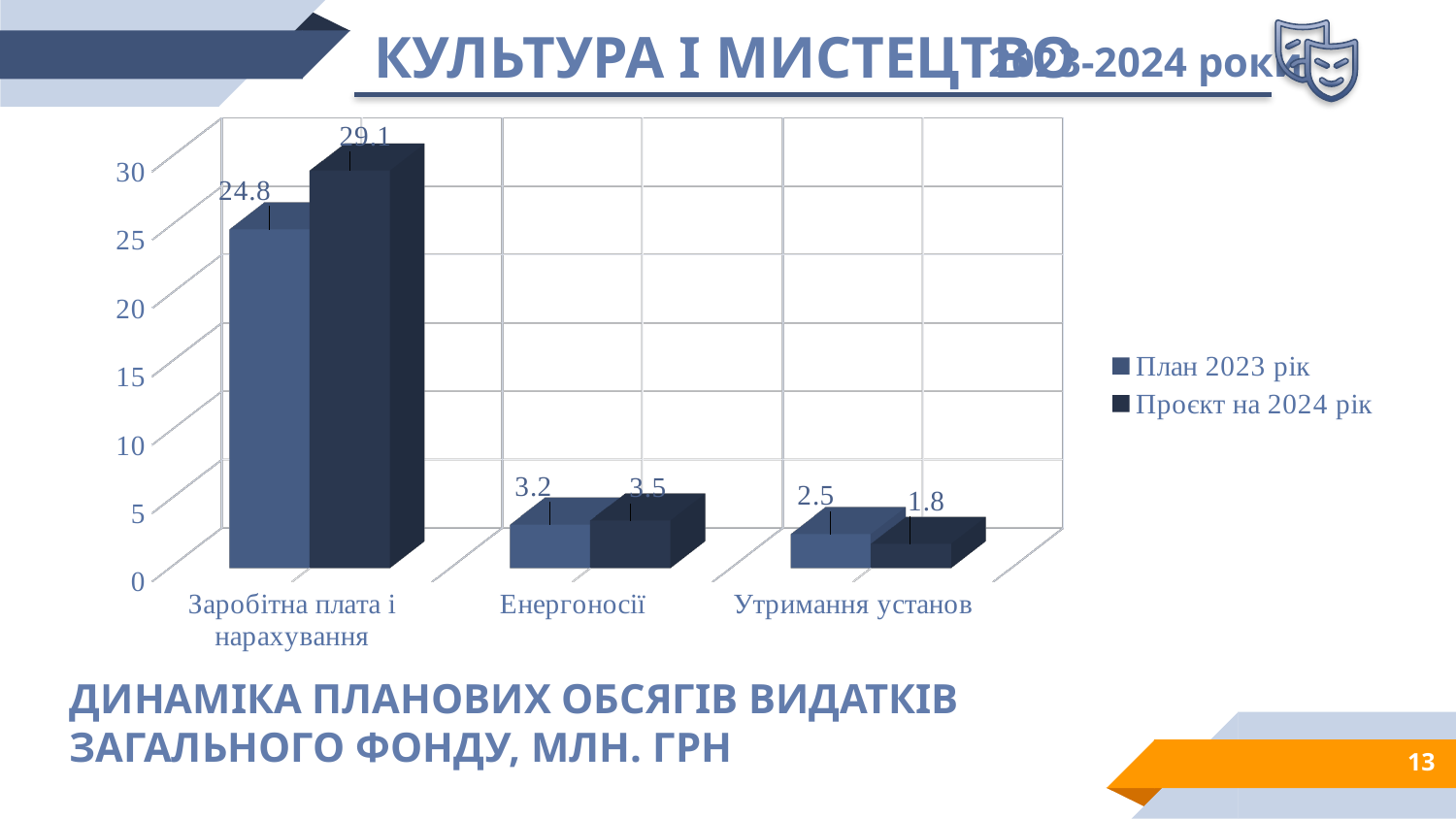
Which category has the highest value in the "Проєкт на 2024 рік" series? Заробітна плата і нарахування How many categories are shown on the x axis of the chart? 3 What is the value for "Утримання установ" in the "План 2023 рік" series? 2.5 What kind of chart is shown on the slide? bar chart How many series does the chart legend list? 2 What is the difference between the "Проєкт на 2024 рік" and "План 2023 рік" values for "Заробітна плата і нарахування"? 4.3 For "Утримання установ", which is larger: the "План 2023 рік" value or the "Проєкт на 2024 рік" value? План 2023 рік Is the "План 2023 рік" value for "Заробітна плата і нарахування" greater or less than 20? greater What is the value for "Енергоносії" in the "Проєкт на 2024 рік" series? 3.5 What is the value for "Заробітна плата і нарахування" in the "Проєкт на 2024 рік" series? 29.1 Which category has the lowest value in the "Проєкт на 2024 рік" series? Утримання установ What is the value for "Заробітна плата і нарахування" in the "План 2023 рік" series? 24.8